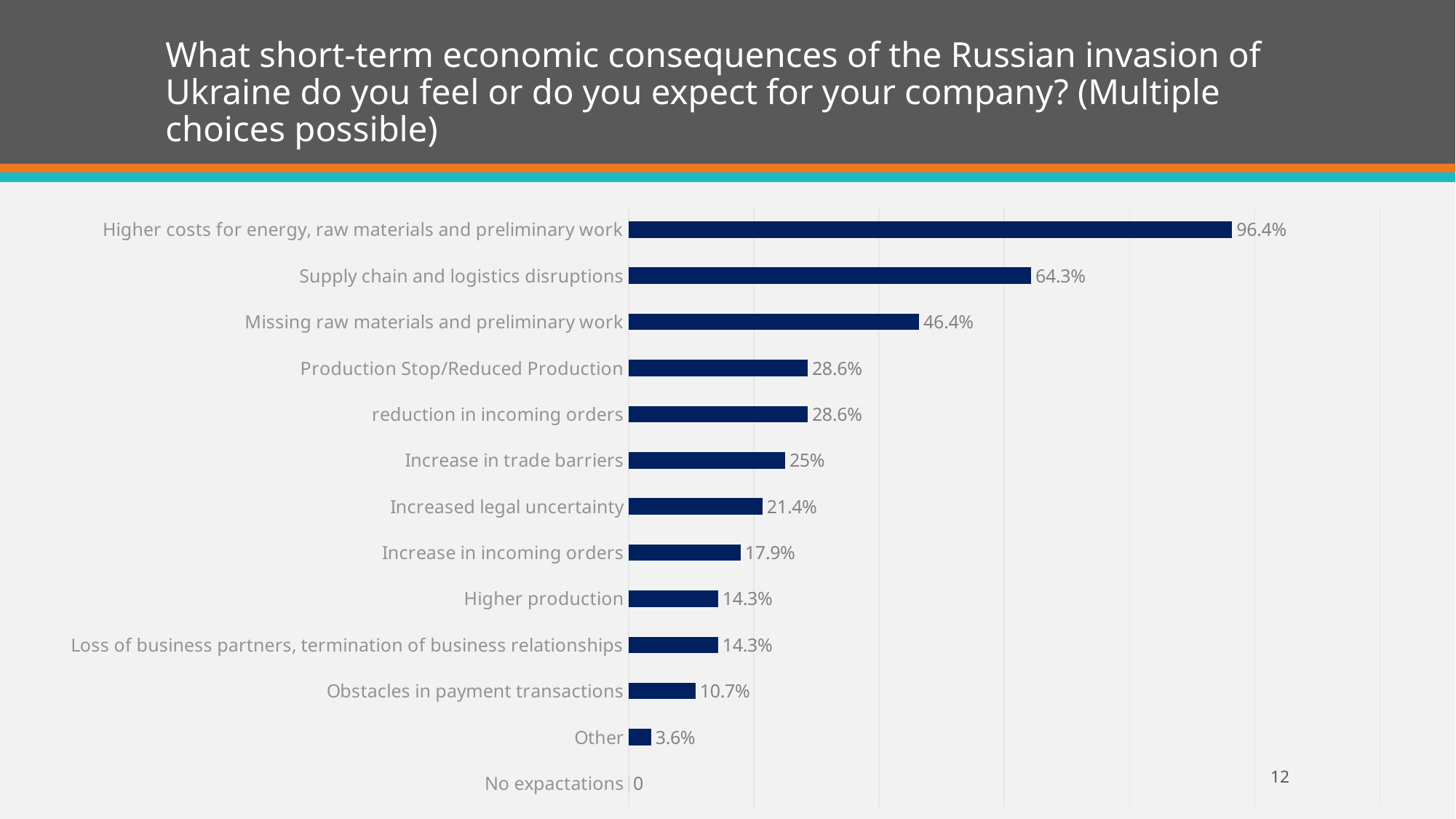
What is the value for 'Increased legal uncertainty'? 21.4% Which category has the lowest value? No expactations How many categories are shown in the chart? 13 What is the value for 'Supply chain and logistics disruptions'? 64.3% What value is shown for 'Other'? 3.6% What is the value for 'Obstacles in payment transactions'? 10.7% What is the difference between 'Supply chain and logistics disruptions' and 'Missing raw materials and preliminary work'? 17.9% Which category has the highest value? Higher costs for energy, raw materials and preliminary work What kind of chart is shown on the slide? Bar chart Which is larger: 'Increase in trade barriers' or 'Increase in incoming orders'? Increase in trade barriers What is the difference between 'Higher costs for energy, raw materials and preliminary work' and 'Other'? 92.8% What percentage of respondents selected 'Higher costs for energy, raw materials and preliminary work'? 96.4%